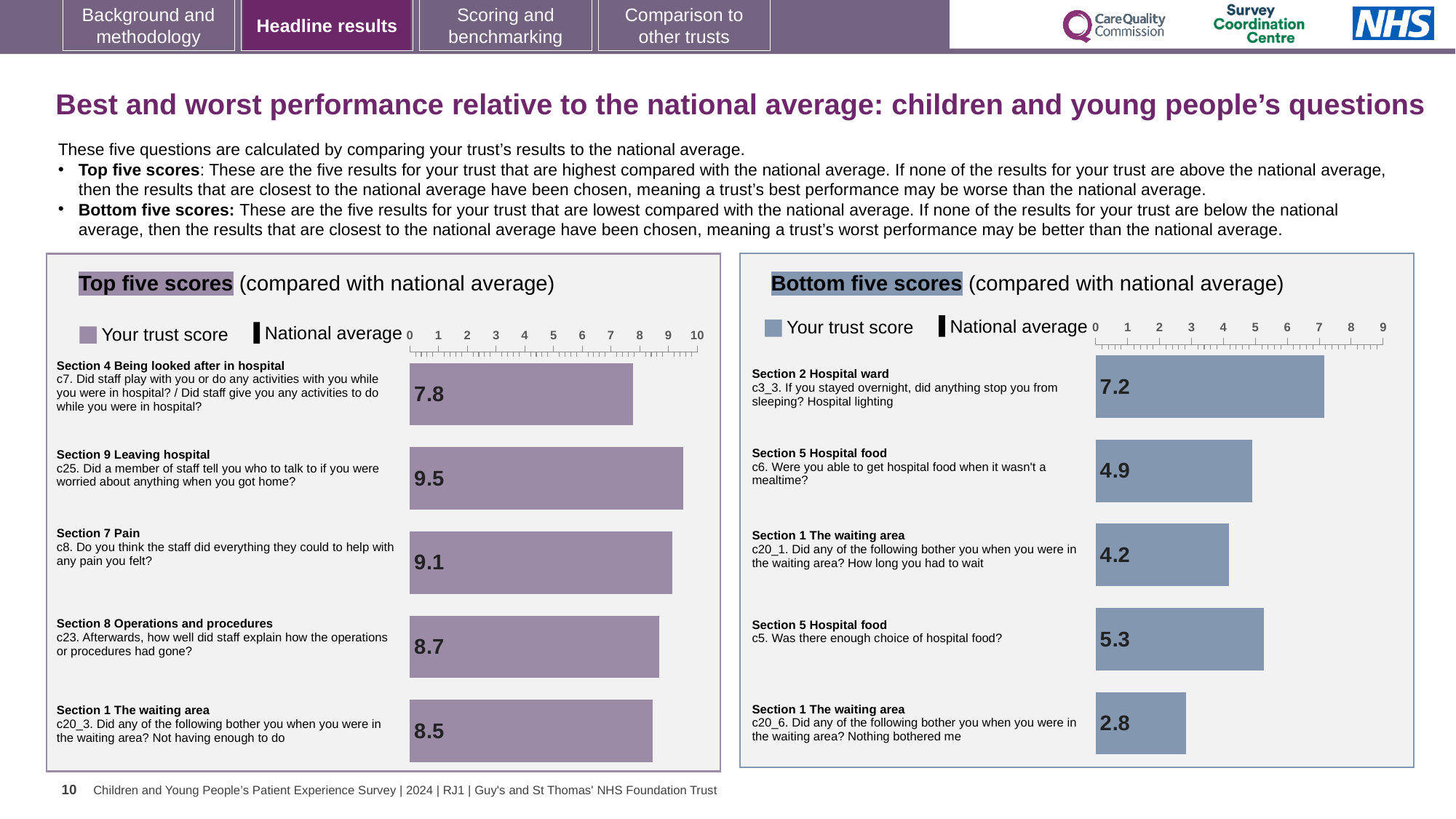
What type of chart is used for the Top five scores? Bar chart In the Bottom five scores chart, which has the larger trust score: c5 (enough choice of hospital food) or c20_1 (how long you had to wait)? c5 (5.3) In the Bottom five scores chart, what is the trust score for c6 (Were you able to get hospital food when it wasn't a mealtime?)? 4.9 In the Bottom five scores chart, which question has the lowest trust score? c20_6 (Nothing bothered me in the waiting area), 2.8 In the Top five scores chart, which question has the highest trust score? c25 (Section 9 Leaving hospital), 9.5 In the Top five scores chart, what is the difference between the trust scores for c25 and c7? 1.7 In the Bottom five scores chart, what is the difference between the trust scores for c3_3 (hospital lighting) and c20_6 (nothing bothered me)? 4.4 How many bars are plotted in the Top five scores chart? 5 How many series does the legend of the Bottom five scores chart list? 2 In the Top five scores chart, what is the trust score for c25 (Did a member of staff tell you who to talk to if you were worried about anything when you got home?)? 9.5 In the Top five scores chart, is the trust score for c8 (pain) greater or less than 8? greater What are the two legend entries shown for the Top five scores chart? Your trust score; National average